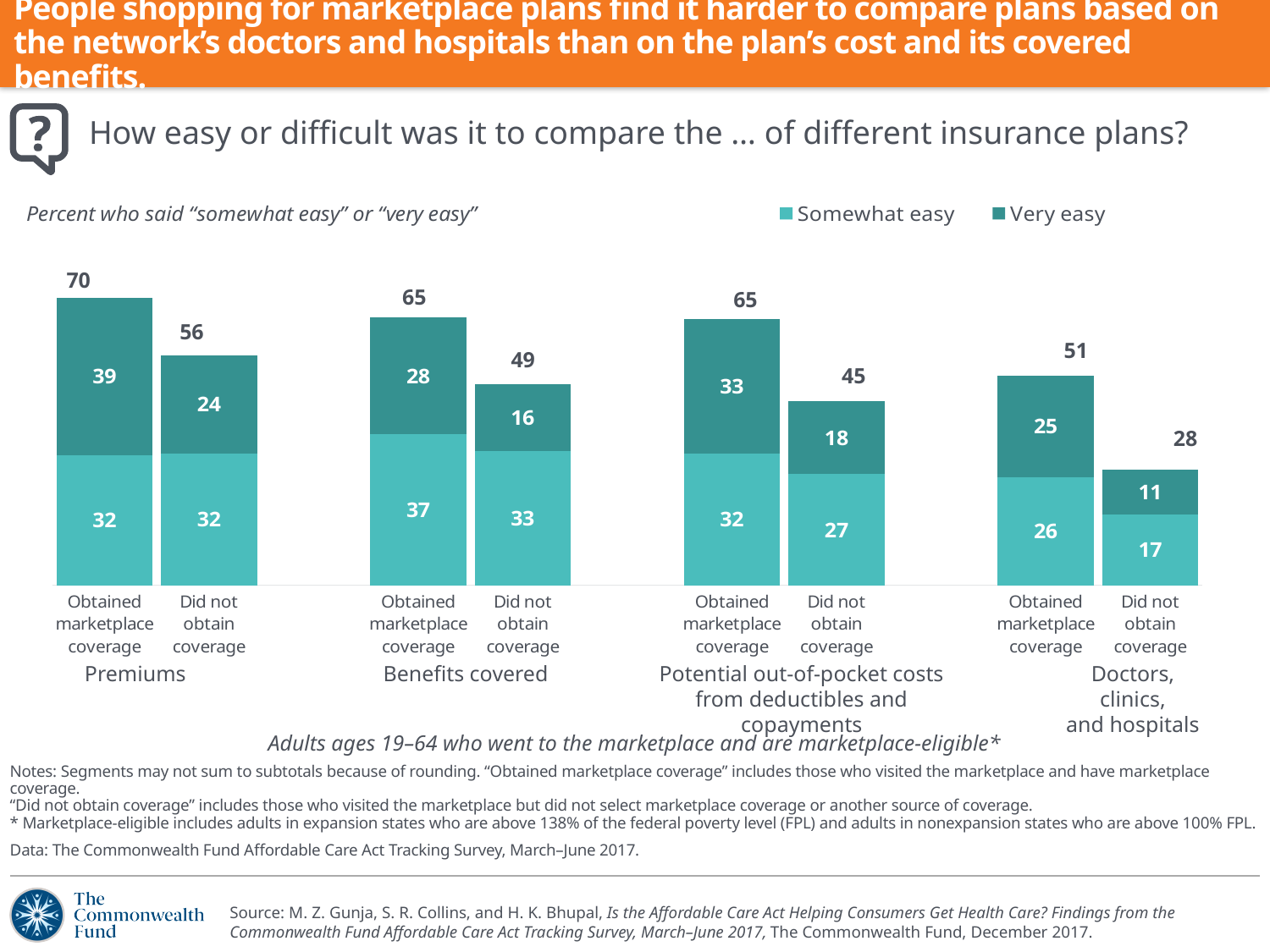
What is the difference between the total for "Obtained marketplace coverage" and "Did not obtain coverage" for premiums? 14 Which bar has the lowest total percent on the chart? Doctors, clinics, and hospitals, Did not obtain coverage How many bars are plotted on the chart? 8 How many series does the legend list? 2 What is the total percent who said comparing benefits covered was easy among those who did not obtain coverage? 49 What is the "Somewhat easy" value for adults who did not obtain coverage when comparing doctors, clinics, and hospitals? 17 For potential out-of-pocket costs, which is larger: the "Very easy" value for those who obtained marketplace coverage or for those who did not obtain coverage? Obtained marketplace coverage What is the "Very easy" value for adults who obtained marketplace coverage when comparing premiums? 39 What is the difference between the "Somewhat easy" values for those who obtained marketplace coverage and those who did not, for benefits covered? 4 What type of chart is shown on the slide? Stacked bar chart Which bar has the highest total percent on the chart? Premiums, Obtained marketplace coverage What are the two legend entries on the chart? Somewhat easy; Very easy